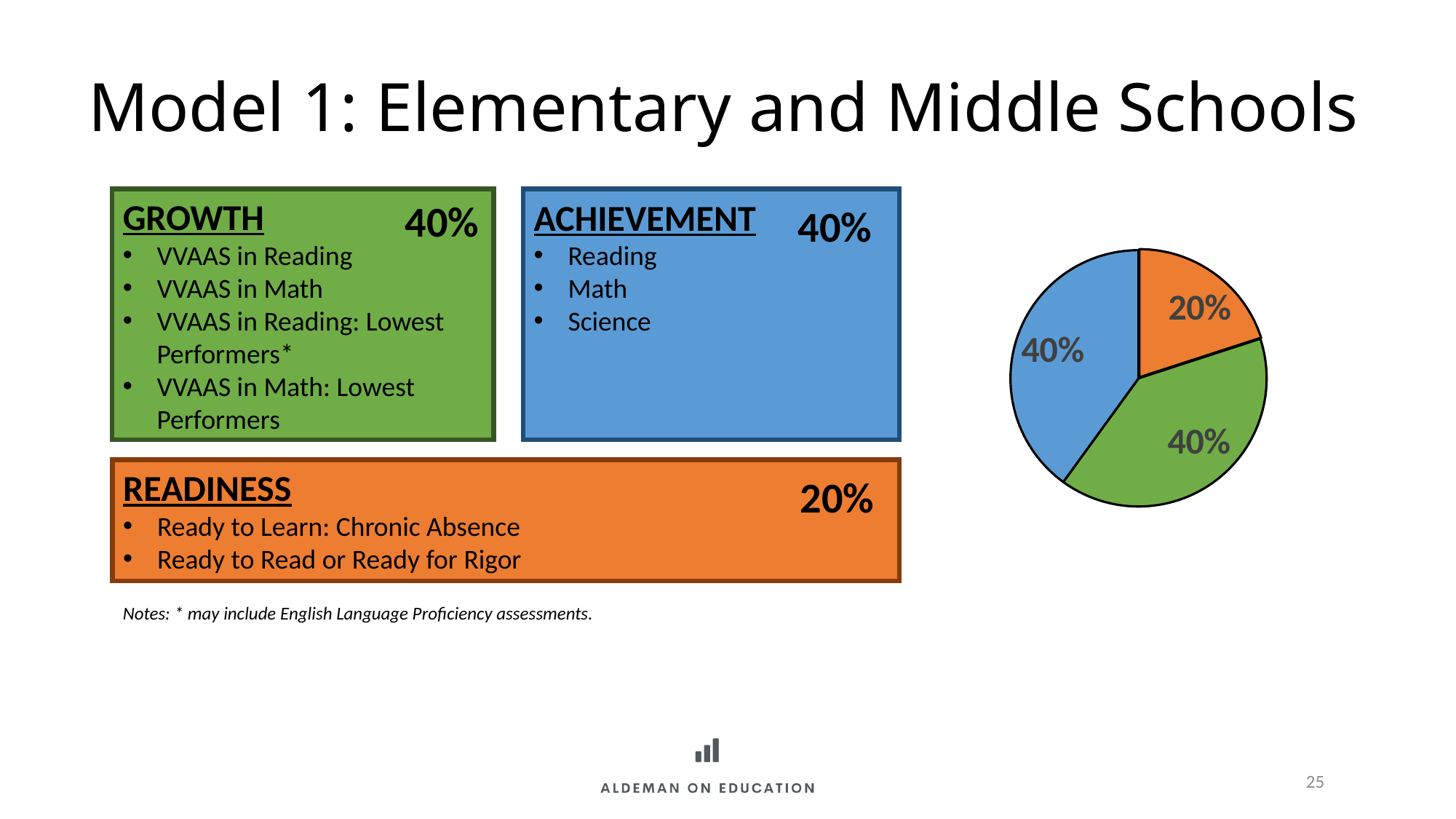
How many slices does the pie chart have? 3 What percentage is shown on the orange slice of the pie chart? 20% Is the green slice of the pie chart larger or smaller than the orange slice? larger Which colour slice of the pie chart is the smallest? orange What is the total of all the slices shown in the pie chart? 100% What is the difference between the blue slice and the orange slice of the pie chart? 20% What kind of chart is shown on the right side of the slide? pie chart What share of the pie chart do the green and blue slices together make up? 80% What percentage is shown on the blue slice of the pie chart? 40% What percentage is shown on the green slice of the pie chart? 40% Which colour in the pie chart matches the READINESS box on the slide? orange Is the value of the orange slice of the pie chart greater or less than 30%? less